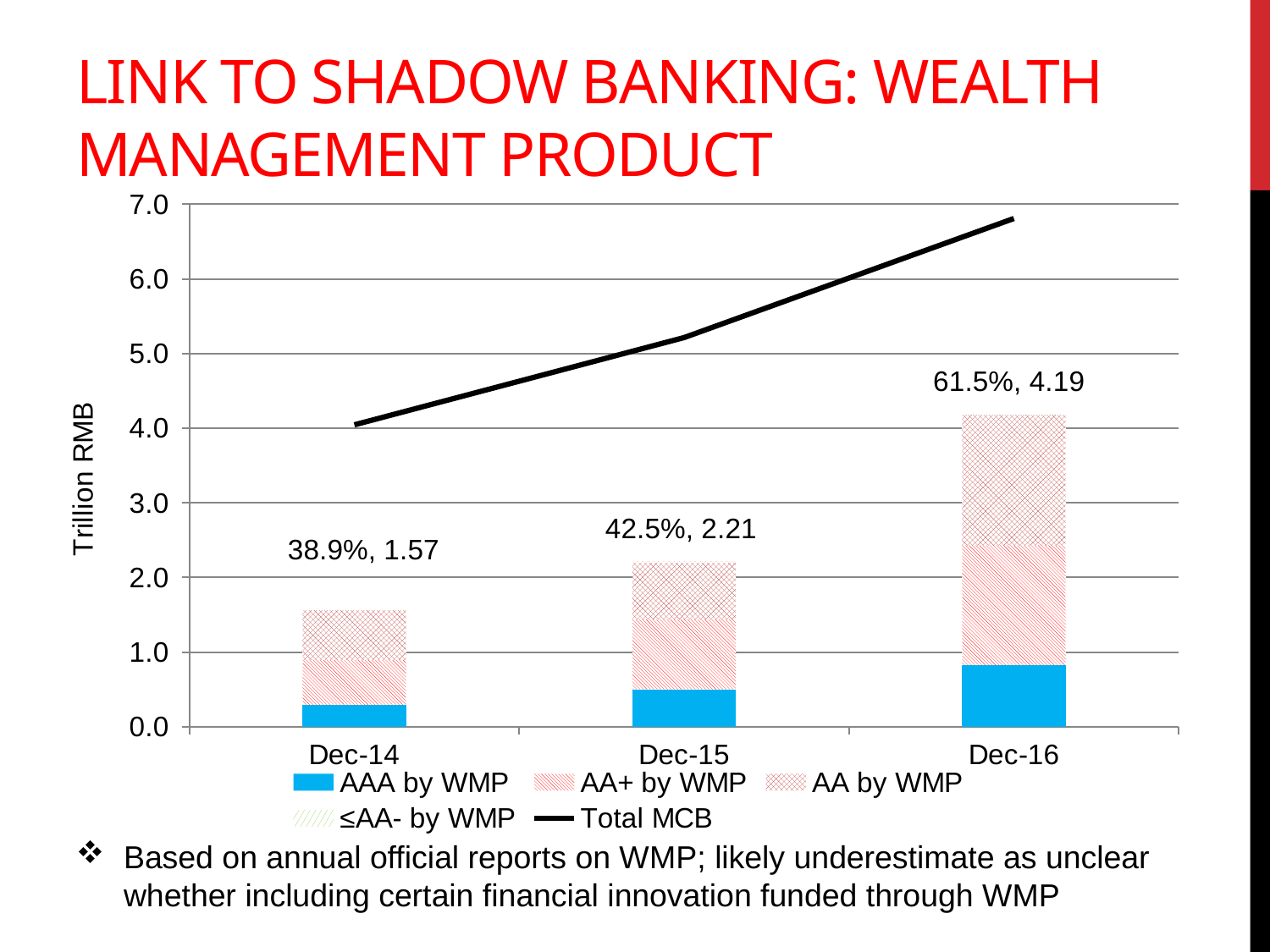
How many series does the legend list? 5 Is the Total MCB value at Dec-16 greater or less than 6.0? greater What is the difference between the stacked bar totals for Dec-16 and Dec-14? 2.62 What is the total value of the stacked bar for Dec-16? 4.19 What is the total value of the stacked bar for Dec-14? 1.57 Which date has the highest stacked bar total? Dec-16 Which date has the lowest stacked bar total? Dec-14 Does the Total MCB line rise or fall from Dec-14 to Dec-16? rises Which stacked bar total is larger, Dec-15 or Dec-14? Dec-15 Is the Total MCB value at Dec-14 greater or less than 5.0? less How many dates are shown on the x axis? 3 What percentage is shown in the data label above the Dec-15 bar? 42.5%